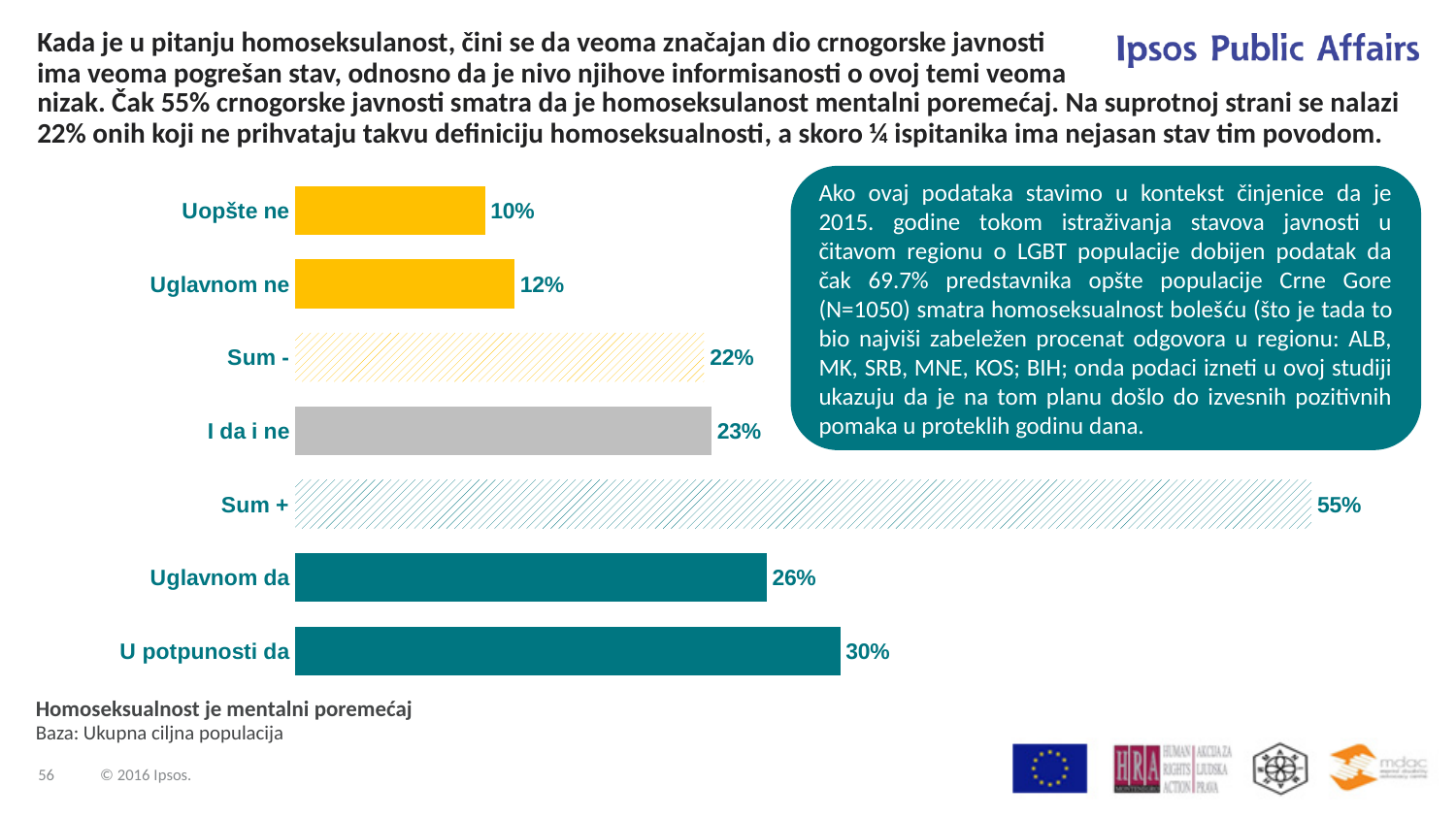
What statement is the chart about, as given in the caption below it? Homoseksualnost je mentalni poremećaj What is the value for "U potpunosti da"? 30% What is the difference between "Sum +" and "Sum -"? 33% Which category has the highest value? Sum + Which category has the lowest value? Uopšte ne What kind of chart is shown on the slide? Bar chart What is the value for "Sum +"? 55% Which is larger, "Uglavnom ne" or "Uglavnom da"? Uglavnom da What is the value for "Uopšte ne"? 10% What is the difference between "U potpunosti da" and "Uglavnom da"? 4% What is the value for "I da i ne"? 23% How many categories are shown in the chart? 7